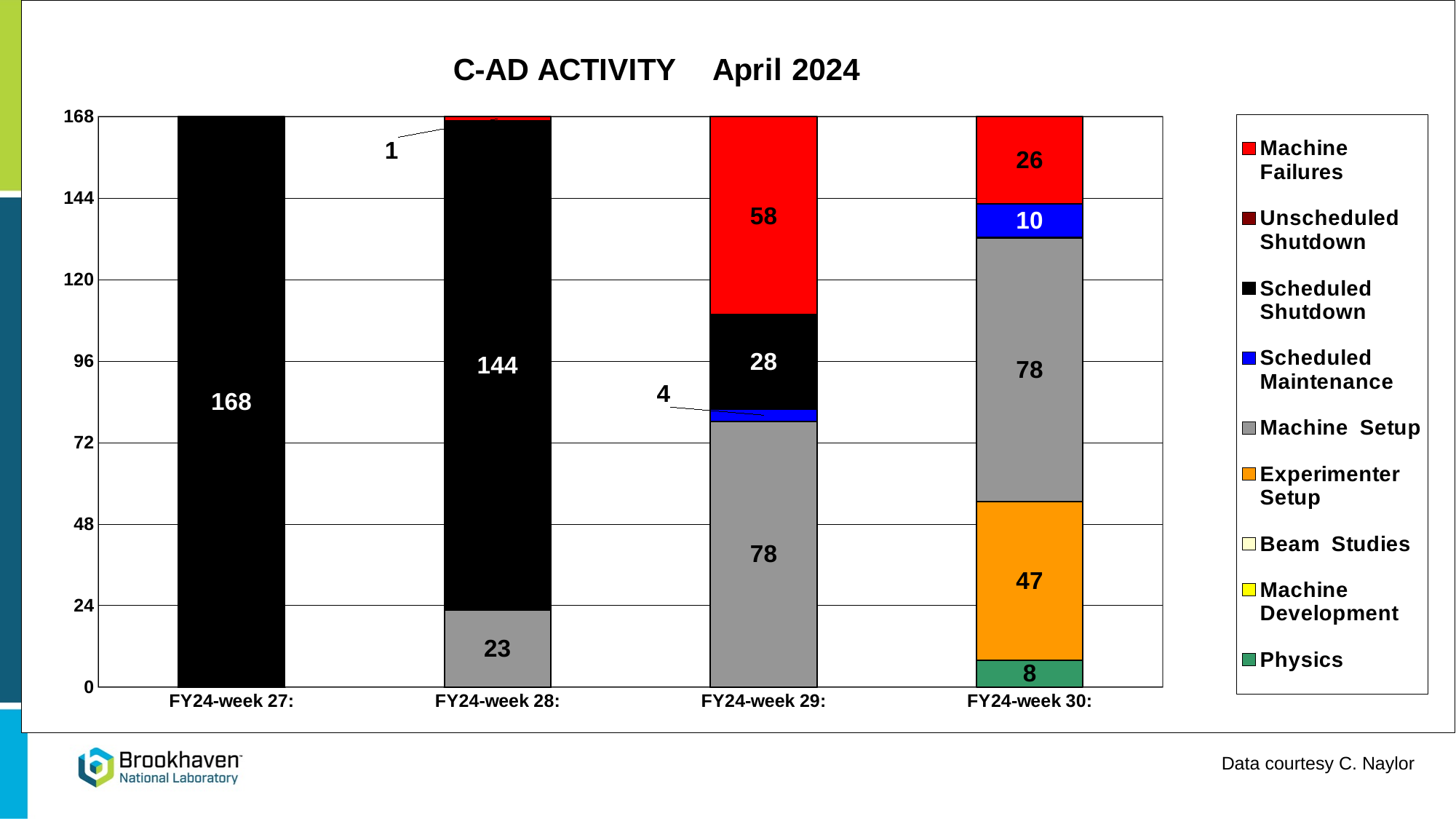
What is the value for Experimenter Setup in FY24-week 30? 47 What is the value for Machine Failures in FY24-week 29? 58 What is the value for Scheduled Shutdown in FY24-week 27? 168 What is the value for Physics in FY24-week 30? 8 Which week has the highest Machine Failures value? FY24-week 29 What is the value for Machine Setup in FY24-week 28? 23 Which is larger, the Scheduled Shutdown value for FY24-week 28 or for FY24-week 29? FY24-week 28 How many weeks are shown on the x axis? 4 What is the difference between the Machine Failures values for FY24-week 29 and FY24-week 30? 32 How many series does the legend list? 9 What is the total of the stacked bar for FY24-week 29? 168 What is the value for Scheduled Maintenance in FY24-week 29? 4